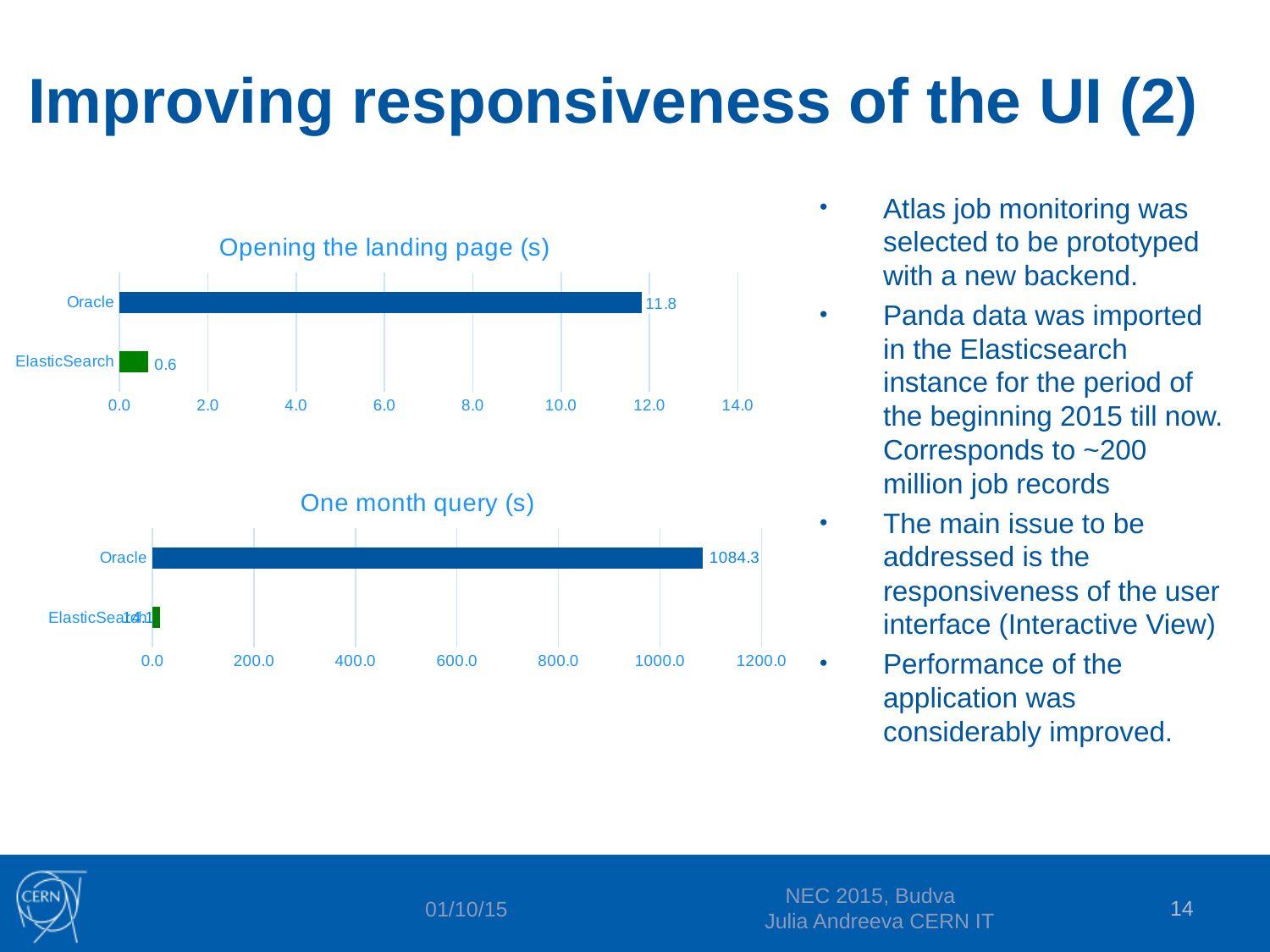
In the 'One month query (s)' chart, what is the value for Oracle? 1084.3 In the 'One month query (s)' chart, is the value for ElasticSearch greater or less than 200.0? less What is the title of the lower chart on the slide? One month query (s) In the 'Opening the landing page (s)' chart, what is the difference between the Oracle and ElasticSearch values? 11.2 In the 'One month query (s)' chart, is the value for Oracle greater or less than 1000.0? greater In the 'Opening the landing page (s)' chart, what is the value for ElasticSearch? 0.6 What type of chart is the 'Opening the landing page (s)' chart? Bar chart In the 'One month query (s)' chart, which category has the lowest value? ElasticSearch In the 'Opening the landing page (s)' chart, what is the value for Oracle? 11.8 How many categories are shown in the 'One month query (s)' chart? 2 In the 'Opening the landing page (s)' chart, which is larger, the value for Oracle or the value for ElasticSearch? Oracle In the 'Opening the landing page (s)' chart, which category has the highest value? Oracle